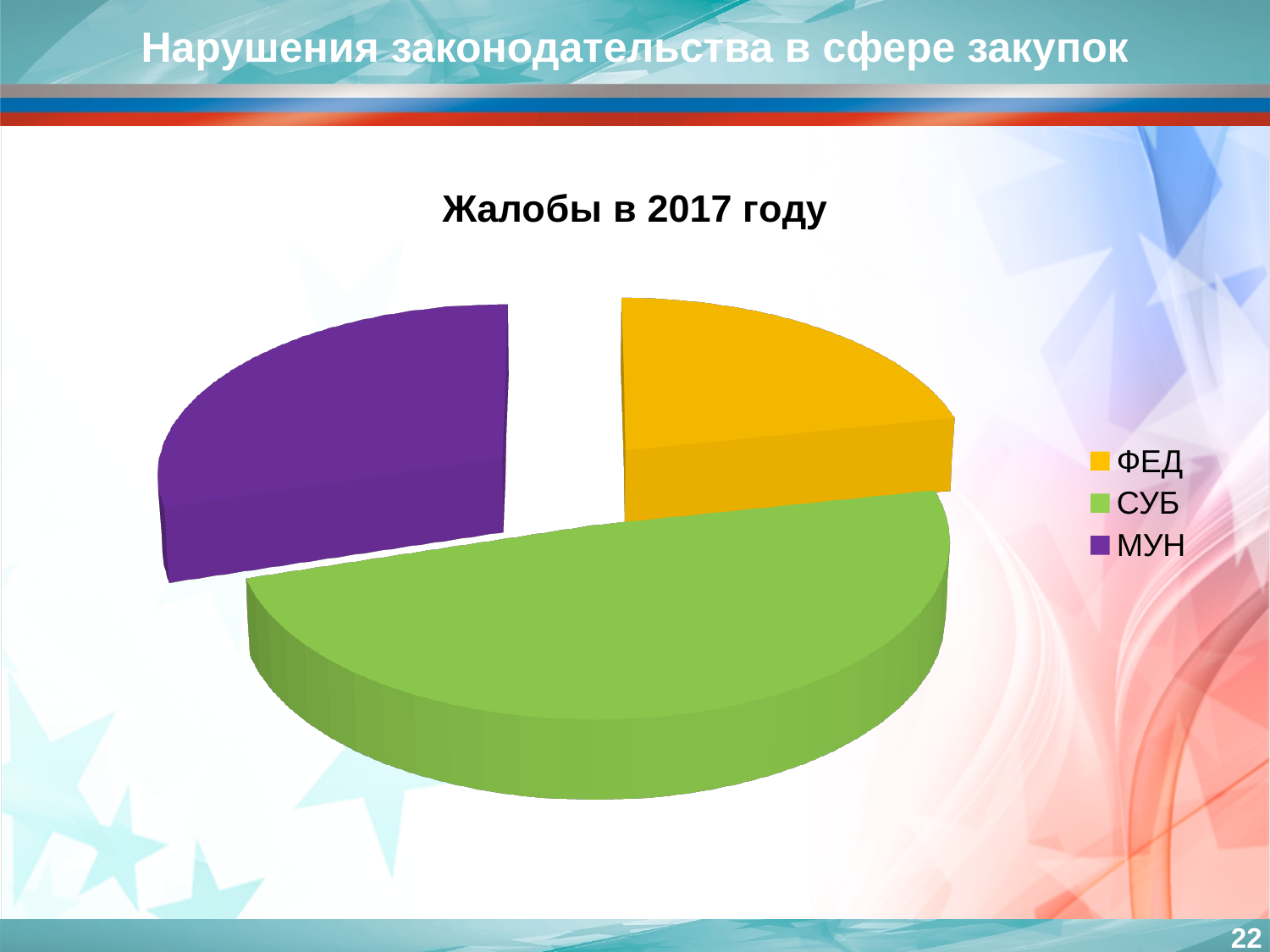
How many entries does the legend of the pie chart list? 3 Which slice is larger, СУБ or МУН? СУБ What is the title of the pie chart? Жалобы в 2017 году What kind of chart is shown on the slide? pie chart Which slice is larger, СУБ or ФЕД? СУБ How many slices does the pie chart have? 3 Which category is shown in purple in the pie chart? МУН Which category has the largest slice in the pie chart? СУБ